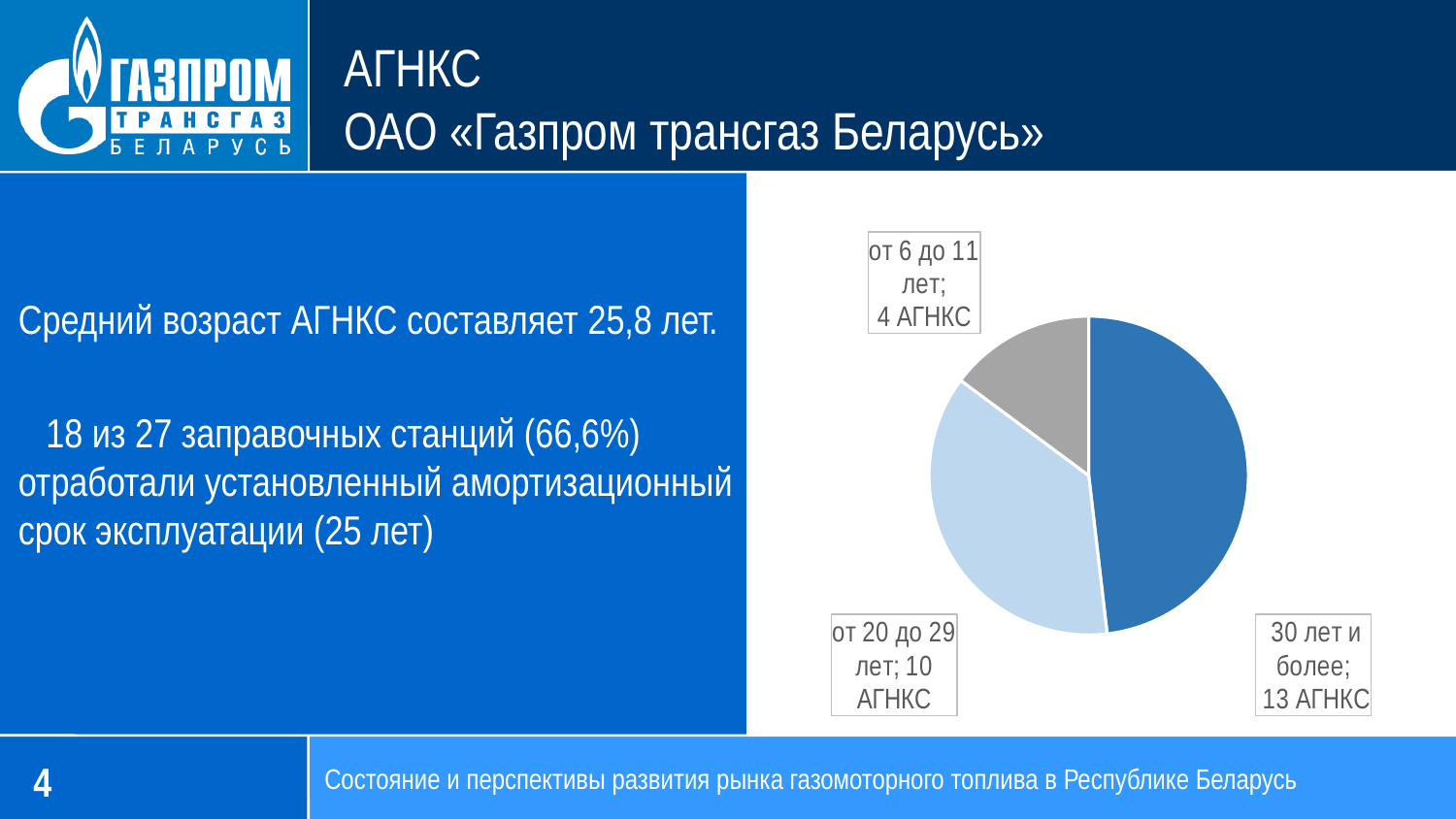
Which has more АГНКС: the "от 6 до 11 лет" category or the "от 20 до 29 лет" category? от 20 до 29 лет How many АГНКС are in the "от 20 до 29 лет" slice? 10 АГНКС Which age category has the smallest number of АГНКС? от 6 до 11 лет What colour is the "30 лет и более" slice of the pie chart? dark blue How many АГНКС are in the "от 6 до 11 лет" slice? 4 АГНКС What is the total number of АГНКС across all slices of the pie chart? 27 What is the difference between the number of АГНКС aged 30 лет и более and those aged от 20 до 29 лет? 3 What kind of chart is shown on the slide? pie chart How many slices does the pie chart have? 3 What is the difference between the number of АГНКС aged от 20 до 29 лет and those aged от 6 до 11 лет? 6 How many АГНКС are in the "30 лет и более" slice? 13 АГНКС Which age category has the largest number of АГНКС? 30 лет и более